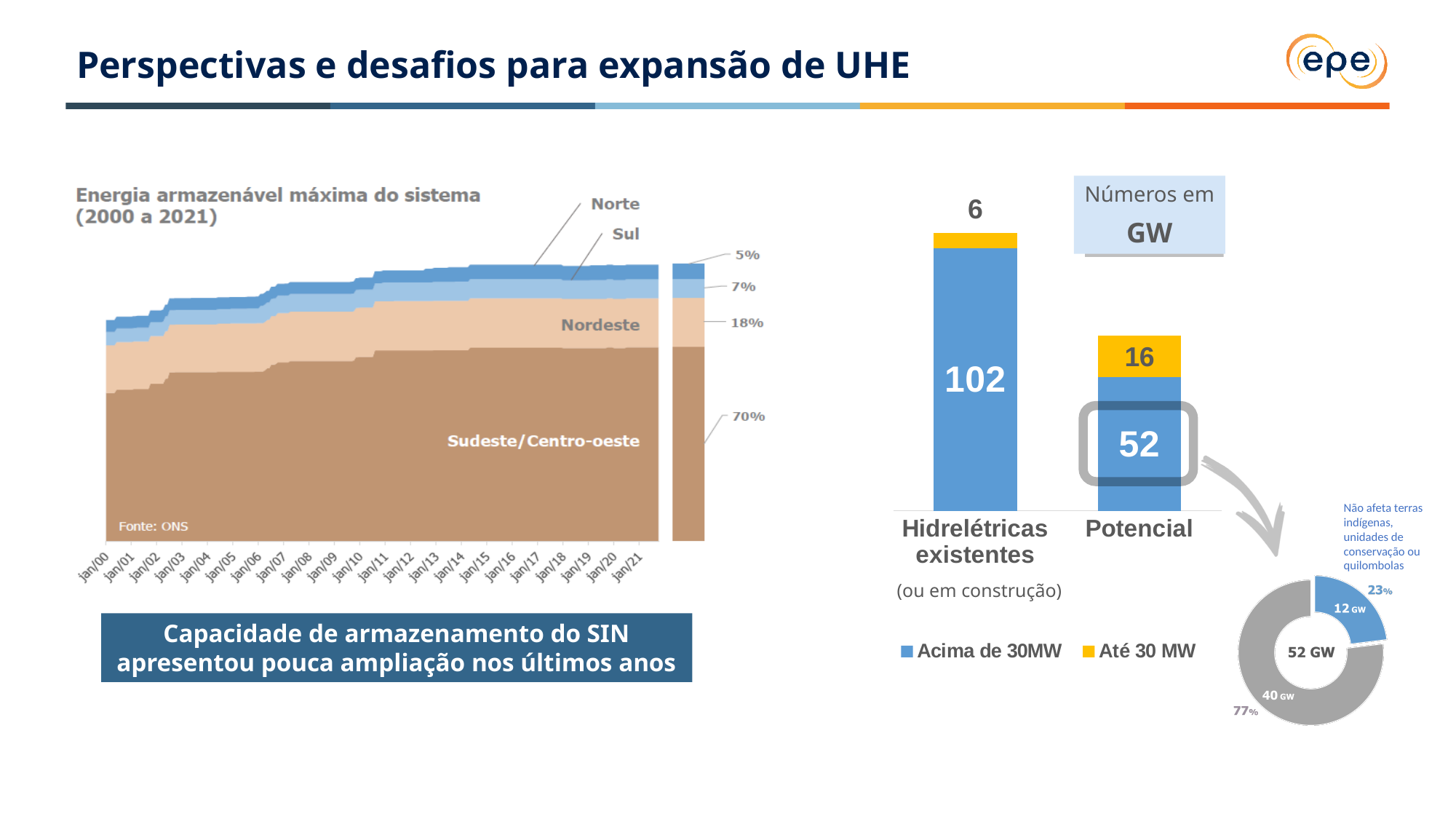
In the donut chart at the bottom right, what share corresponds to the 12 GW slice? 23% In the stacked bar chart on the right, what unit are the numbers given in? GW In the stacked bar chart on the right, what is the value of the 'Acima de 30MW' segment for 'Potencial'? 52 In the stacked bar chart on the right, what is the value of the 'Até 30 MW' segment for 'Potencial'? 16 In the stacked bar chart on the right, which category has the larger 'Até 30 MW' value, 'Hidrelétricas existentes' or 'Potencial'? Potencial In the area chart 'Energia armazenável máxima do sistema (2000 a 2021)', what percentage share is shown for Sudeste/Centro-oeste? 70% In the stacked bar chart on the right, what is the difference between the 'Acima de 30MW' values for 'Hidrelétricas existentes' and 'Potencial'? 50 In the area chart 'Energia armazenável máxima do sistema (2000 a 2021)', which region has the smallest share? Norte In the stacked bar chart on the right, what is the total of the 'Potencial' bar? 68 In the stacked bar chart on the right, what is the value of the 'Acima de 30MW' segment for 'Hidrelétricas existentes'? 102 In the donut chart at the bottom right, what is the value of the larger slice? 40 GW In the stacked bar chart on the right, how many series does the legend list? 2